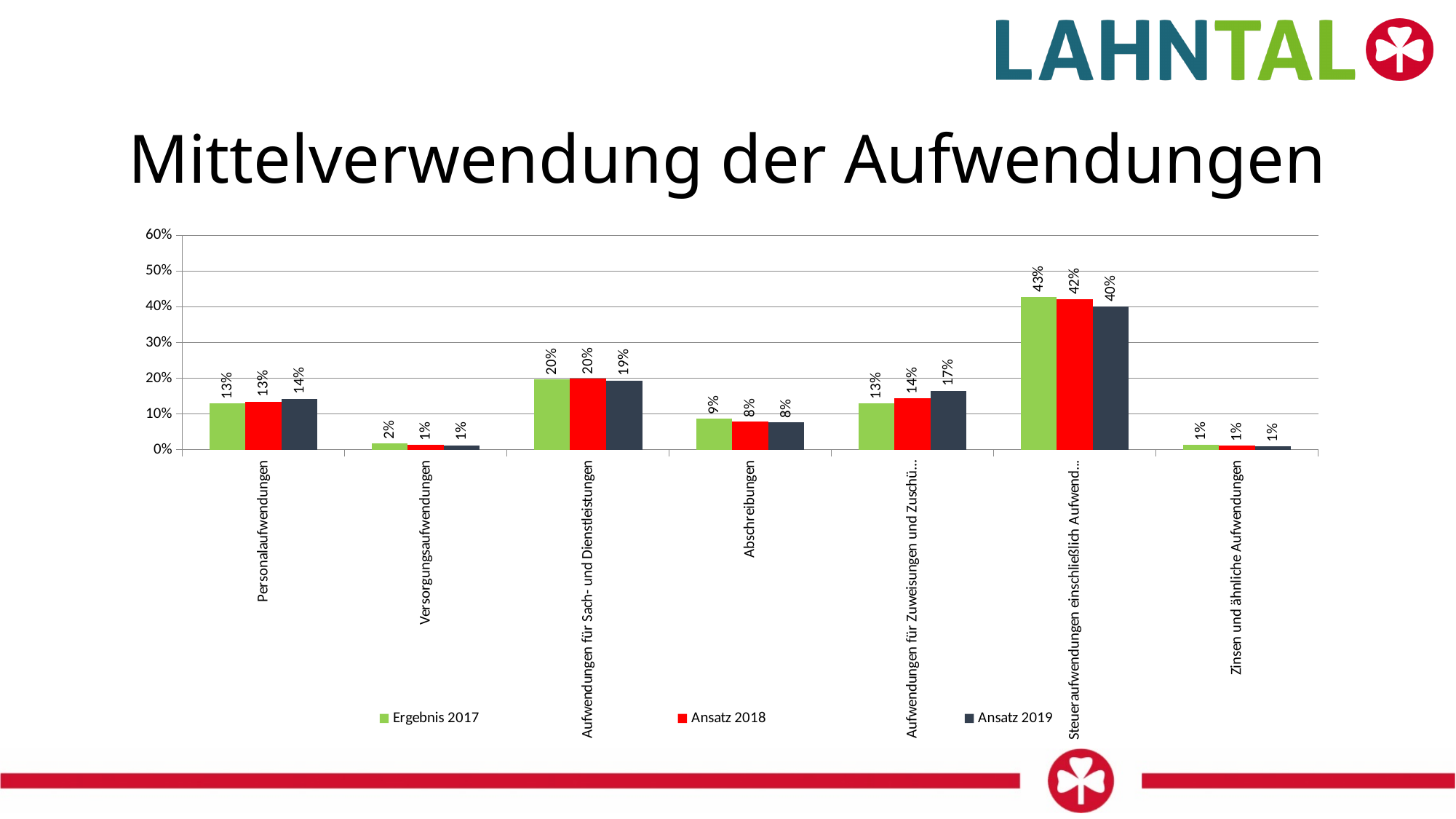
What is the title of the chart on the slide? Mittelverwendung der Aufwendungen What is the Ansatz 2019 value for Personalaufwendungen? 14% What is the Ergebnis 2017 value for Abschreibungen? 9% How many series does the legend list? 3 Is the Ansatz 2018 value for Steueraufwendungen greater or less than 30%? greater What kind of chart is shown on the slide? bar chart What is the Ansatz 2018 value for Aufwendungen für Sach- und Dienstleistungen? 20% How many categories are shown on the x axis? 7 What is the Ergebnis 2017 value for Versorgungsaufwendungen? 2% Which category has the highest Ergebnis 2017 value? Steueraufwendungen einschließlich Aufwend... What is the difference between the Ergebnis 2017 and Ansatz 2019 values for Steueraufwendungen? 3% For Aufwendungen für Zuweisungen und Zuschü..., which is larger: Ansatz 2018 or Ansatz 2019? Ansatz 2019